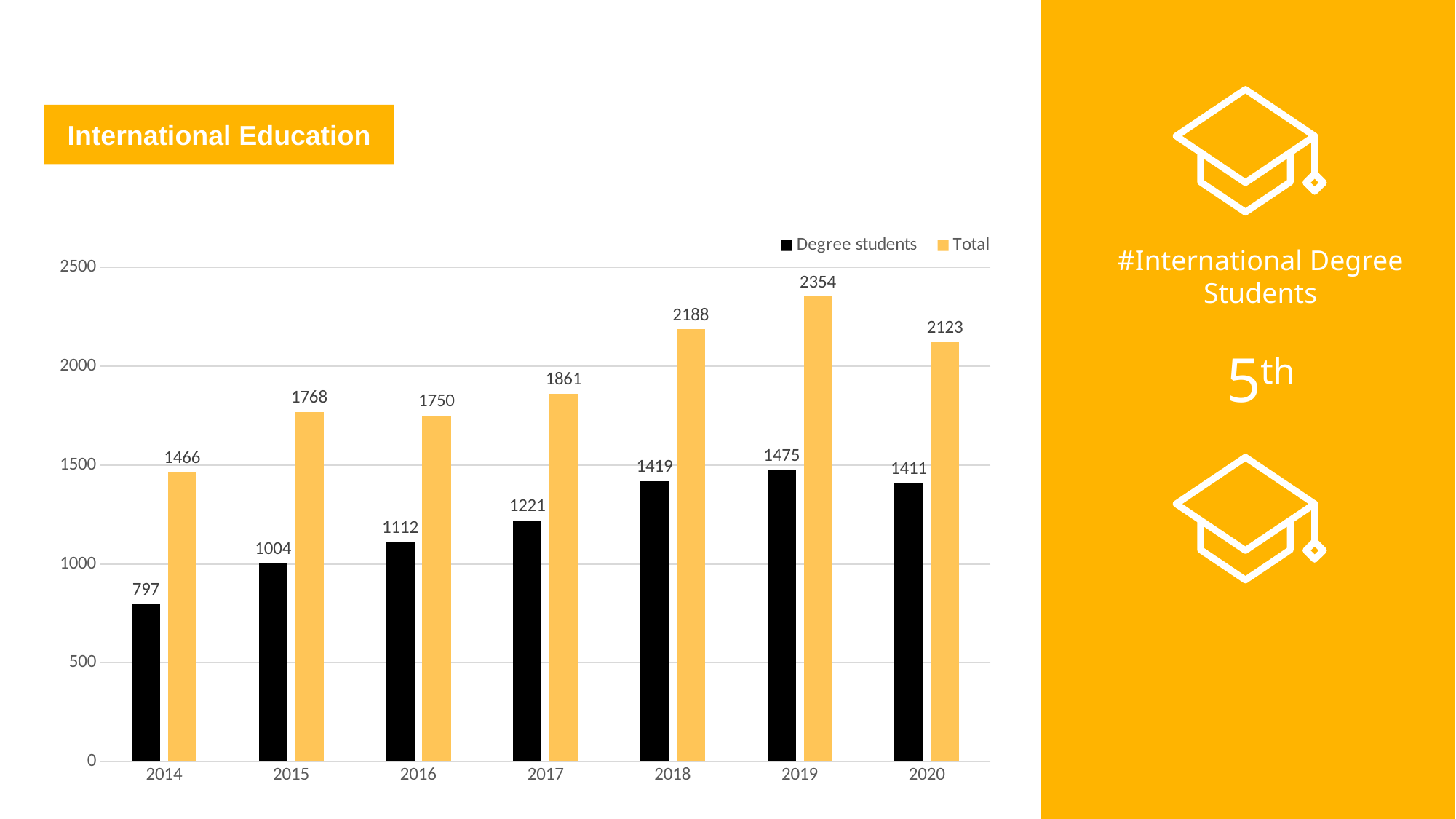
How many series does the legend list? 2 Which year has the highest Total value? 2019 Which year has the lowest Degree students value? 2014 Is the Degree students value for 2017 greater or less than 1000? greater What is the Total value for 2019? 2354 What kind of chart is shown on the slide? bar chart Which is larger, the Total value for 2015 or the Total value for 2016? 2015 What is the difference between the Total and Degree students values in 2018? 769 Which colour represents the Total series? yellow How many years are shown on the x axis? 7 What is the value for Degree students in 2014? 797 What is the value for Degree students in 2020? 1411